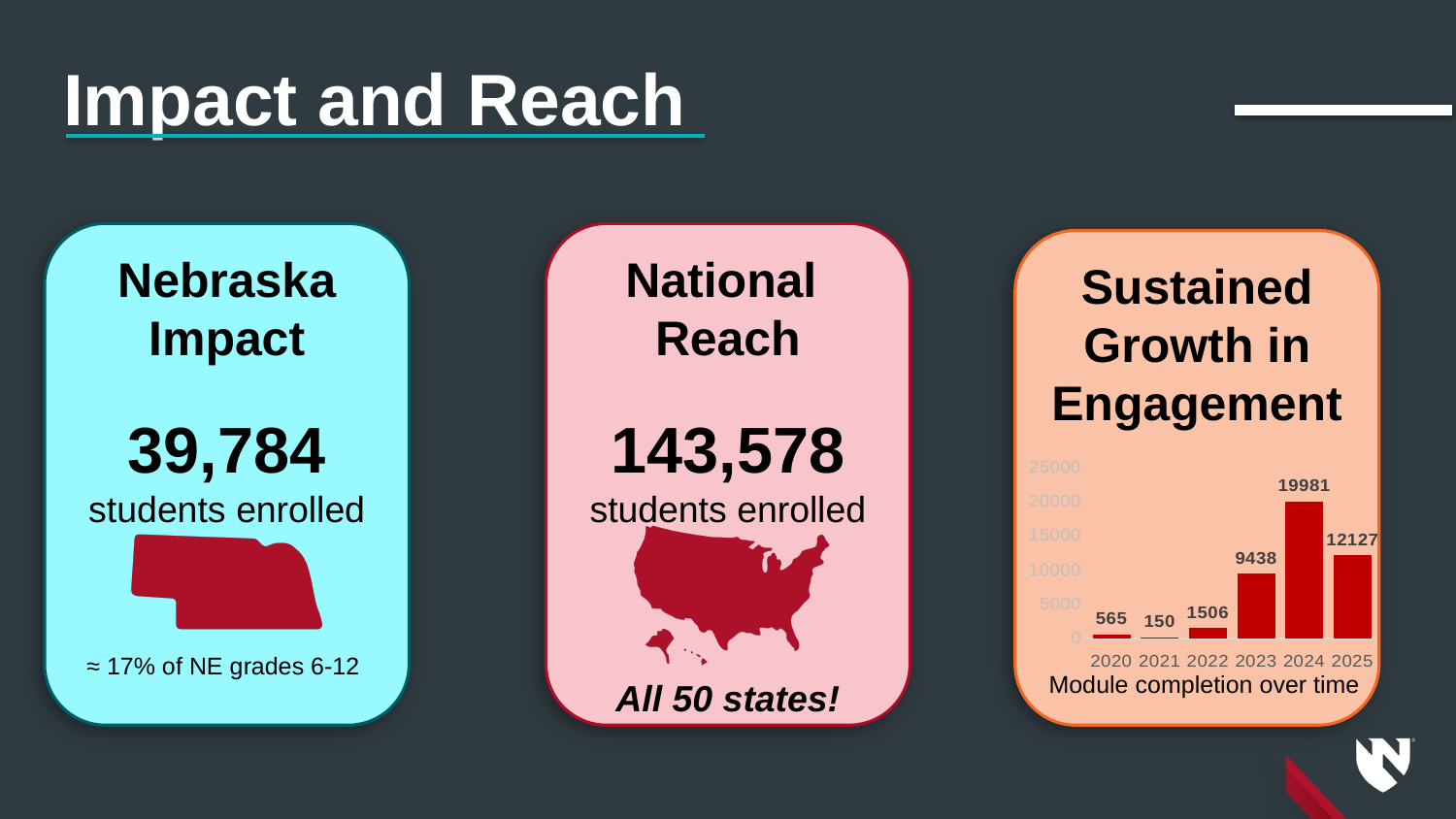
Which year has a larger module completion value, 2020 or 2022? 2022 What is the module completion value for 2024? 19981 What is the module completion value for 2021? 150 What is the difference between the module completion values for 2024 and 2025? 7854 How many years are shown on the x axis of the module completion chart? 6 Is the module completion value for 2025 greater or less than 10000? greater What is the module completion value for 2023? 9438 Which year has the lowest module completion value? 2021 Which year has the highest module completion value? 2024 What is the difference between the module completion values for 2023 and 2022? 7932 What is the caption below the module completion chart? Module completion over time What type of chart is shown in the Sustained Growth in Engagement panel? bar chart